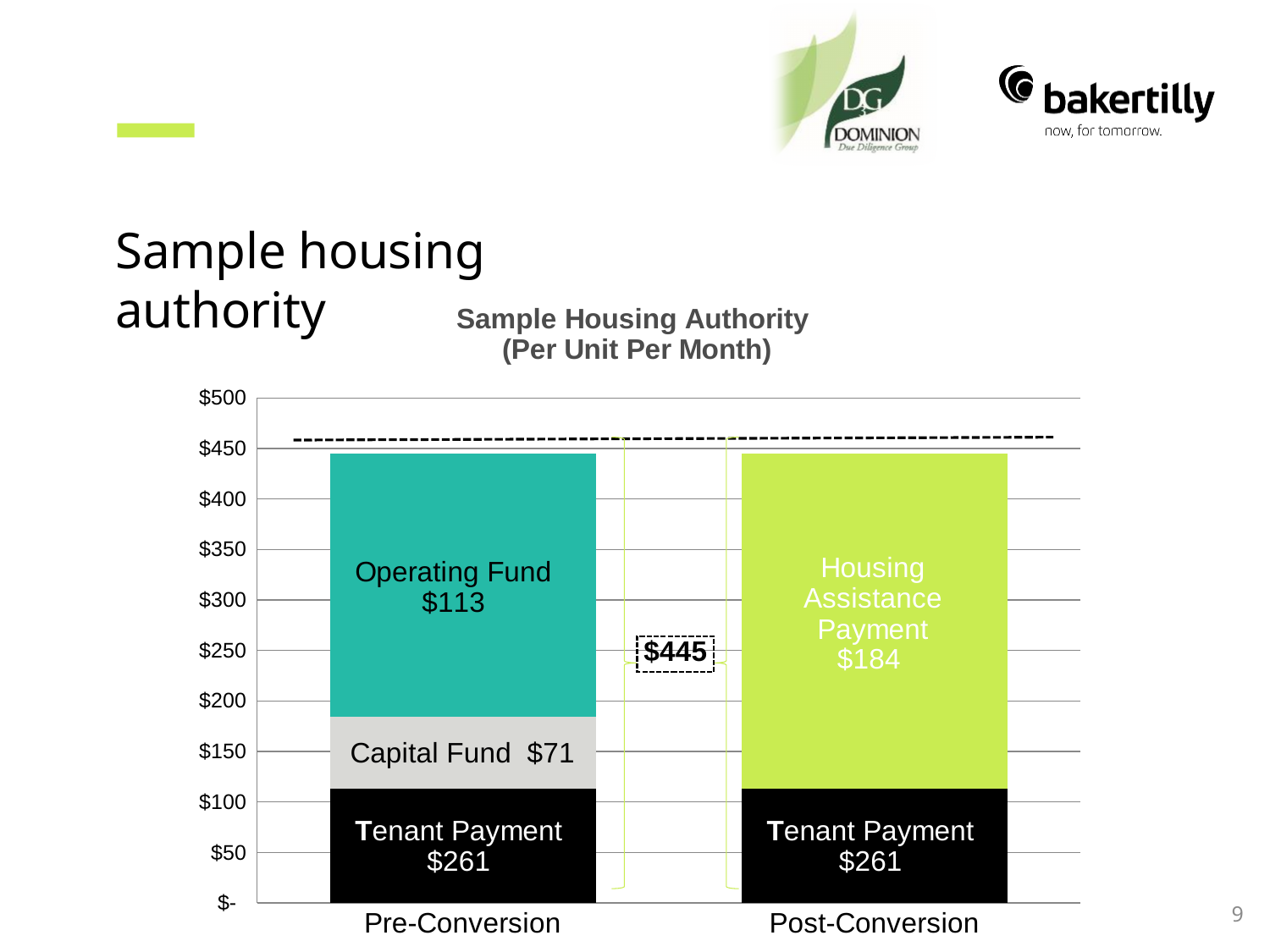
What is the highest value shown on the y axis of the chart? $500 Which is larger in the Pre-Conversion bar, the Operating Fund or the Capital Fund? Operating Fund What is the total of the Pre-Conversion stacked bar? $445 How many categories are shown on the x axis of the chart? 2 What is the total of the Post-Conversion stacked bar? $445 What kind of chart is shown on the slide? Stacked bar chart What is the Housing Assistance Payment value in the Post-Conversion bar? $184 What is the title of the chart? Sample Housing Authority (Per Unit Per Month) What is the Tenant Payment value in the Post-Conversion bar? $261 What is the difference between the Housing Assistance Payment ($184) and the Operating Fund ($113)? $71 What is the Operating Fund value in the Pre-Conversion bar? $113 What is the Capital Fund value in the Pre-Conversion bar? $71